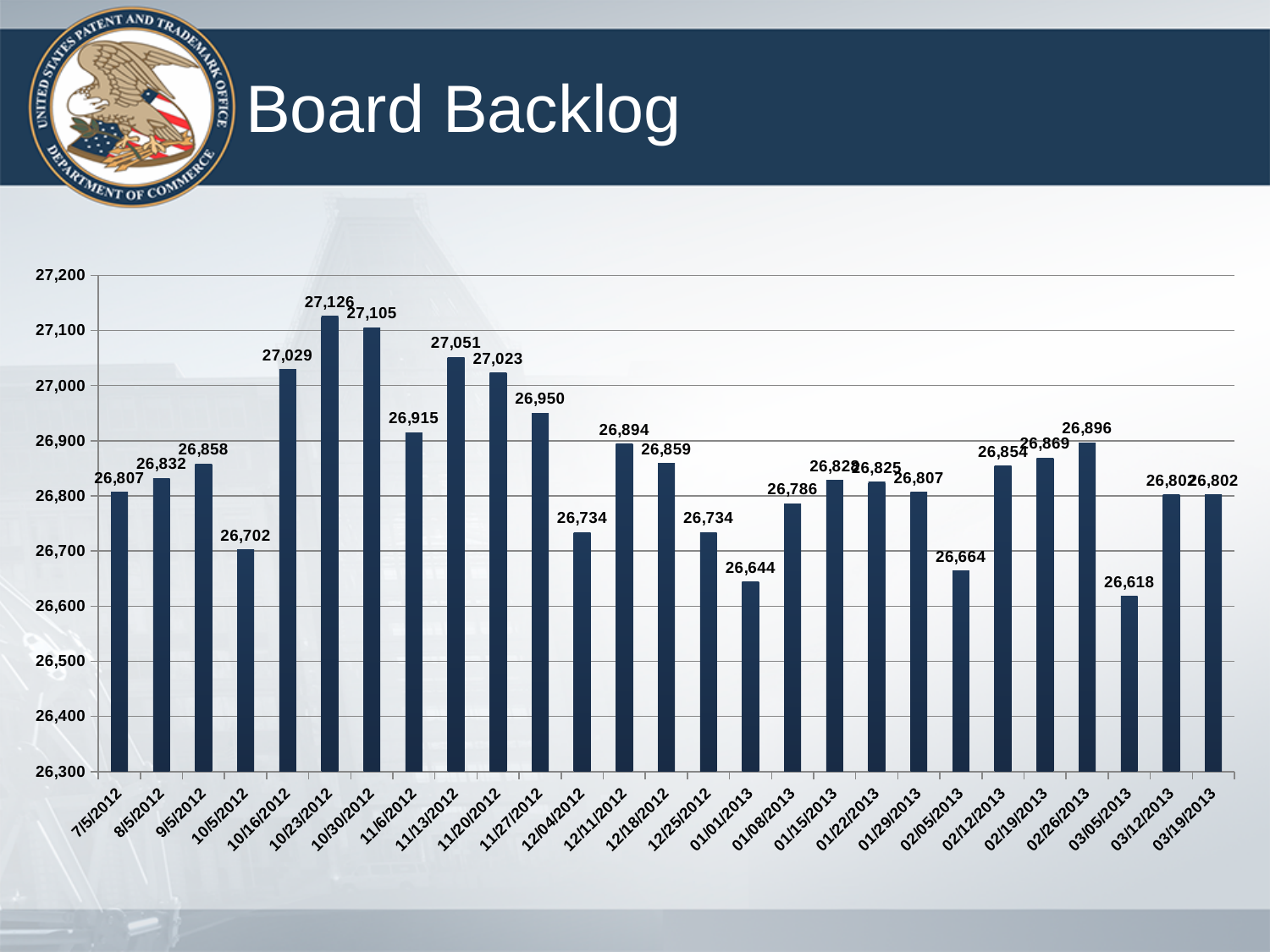
How many dates (bars) are shown on the chart? 27 What type of chart is shown on the slide? bar chart What is the difference between the board backlog on 10/23/2012 and on 03/05/2013? 508 What is the title of the chart? Board Backlog What is the board backlog value for 01/01/2013? 26,644 Which date has the highest board backlog? 10/23/2012 Which date has the lowest board backlog? 03/05/2013 What is the board backlog value for 10/23/2012? 27,126 Which is larger, the board backlog on 10/16/2012 or on 11/27/2012? 10/16/2012 What is the board backlog value for 03/05/2013? 26,618 What is the board backlog value for 11/13/2012? 27,051 Is the board backlog value for 02/05/2013 greater or less than 26,700? less